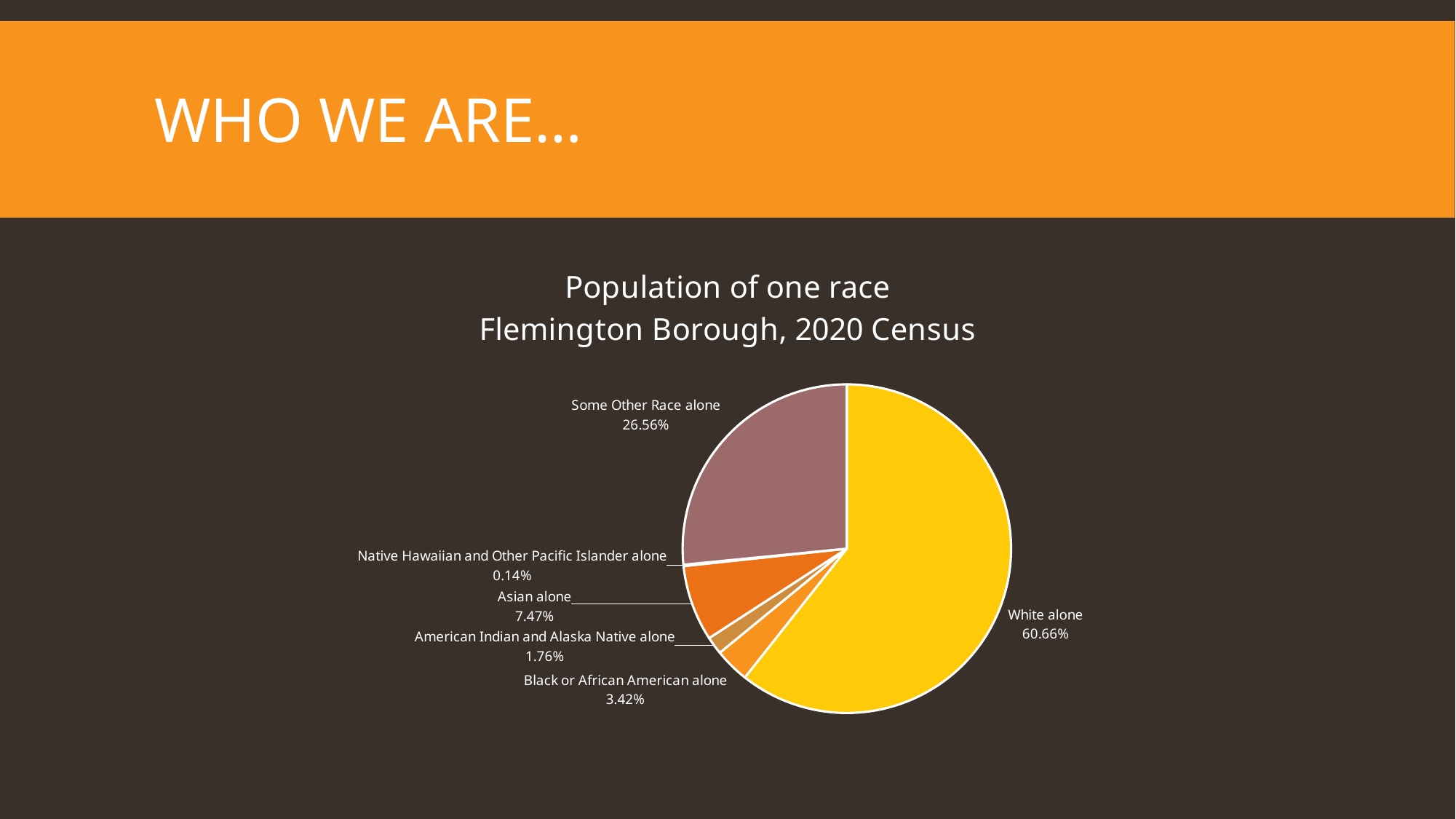
What percentage of the population is Some Other Race alone? 26.56% What kind of chart is shown on the slide? Pie chart What percentage of the population is Native Hawaiian and Other Pacific Islander alone? 0.14% How many categories are shown in the pie chart? 6 Which category has the largest share of the pie? White alone What is the difference in percentage points between White alone and Some Other Race alone? 34.10 What percentage of the population is Black or African American alone? 3.42% What percentage of the population is White alone? 60.66% What percentage of the population is Asian alone? 7.47% What is the title of the chart? Population of one race Flemington Borough, 2020 Census Which category has the smallest share of the pie? Native Hawaiian and Other Pacific Islander alone Which is larger, the share for Asian alone or the share for Black or African American alone? Asian alone